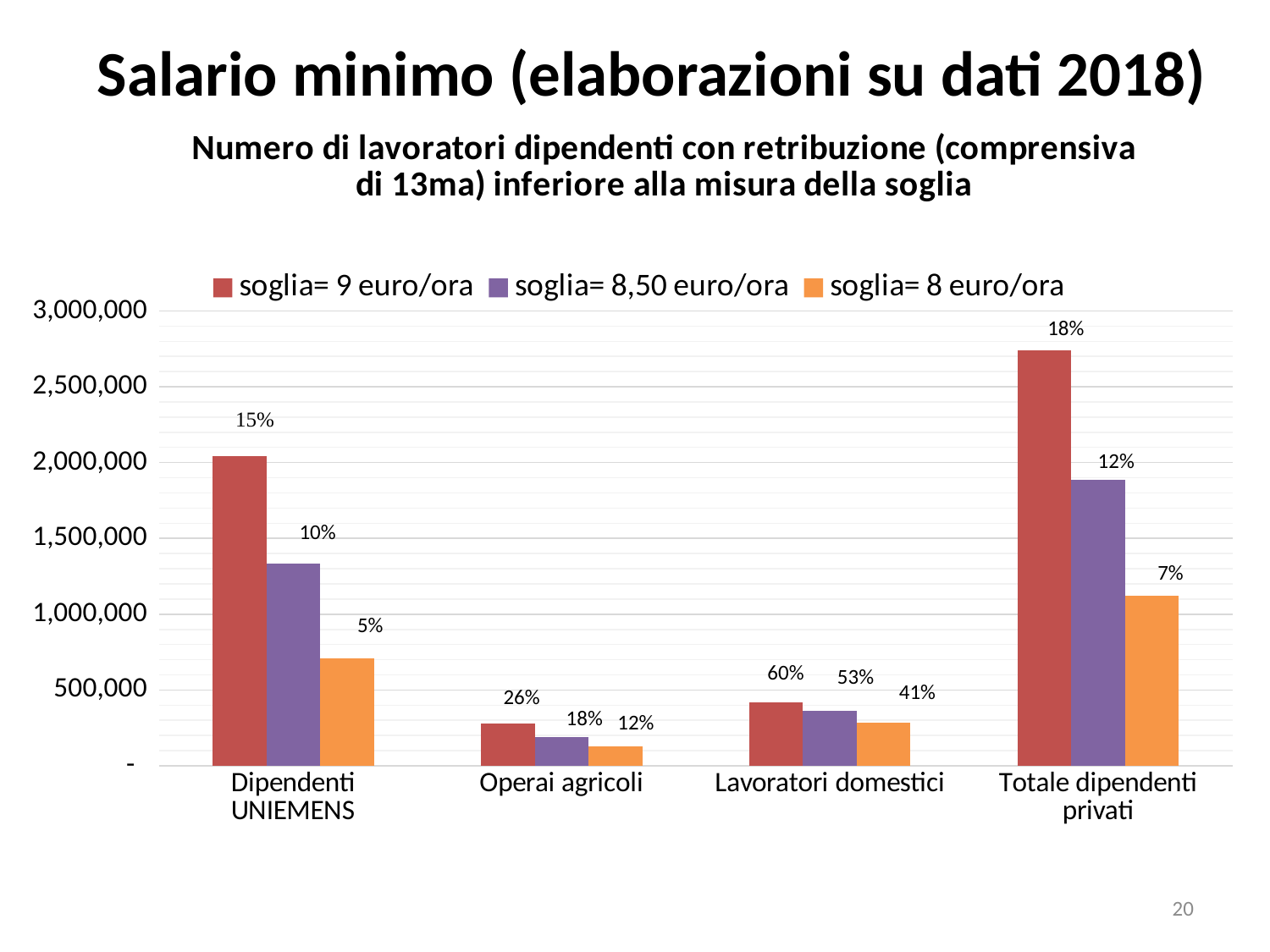
How many categories are shown on the x axis? 4 What colour represents the soglia= 8 euro/ora series in the legend? orange How many series does the legend list? 3 Which is larger: the soglia= 8 euro/ora bar for Dipendenti UNIEMENS or the soglia= 9 euro/ora bar for Lavoratori domestici? soglia= 8 euro/ora bar for Dipendenti UNIEMENS What percentage label is shown on the soglia= 8,50 euro/ora bar for Operai agricoli? 18% What kind of chart is shown on the slide? bar chart Which category has the lowest soglia= 8 euro/ora bar? Operai agricoli Which category has the tallest soglia= 9 euro/ora bar? Totale dipendenti privati What percentage label is shown on the soglia= 9 euro/ora bar for Lavoratori domestici? 60% Is the soglia= 8,50 euro/ora value for Dipendenti UNIEMENS greater or less than 1,500,000? less What percentage label is shown on the soglia= 8 euro/ora bar for Totale dipendenti privati? 7% Is the soglia= 9 euro/ora value for Totale dipendenti privati greater or less than 2,500,000? greater